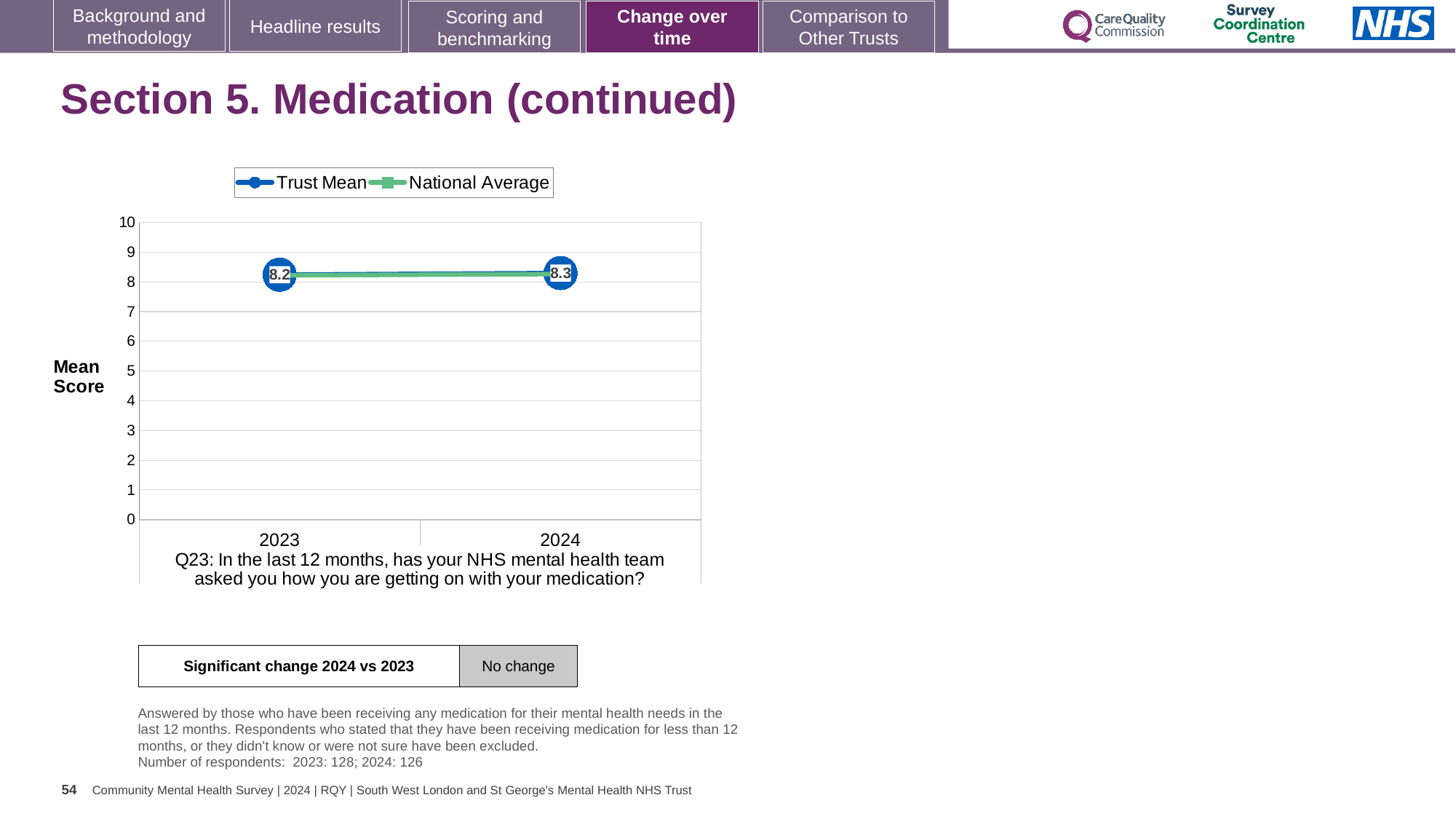
What kind of chart is shown on the slide? line chart What are the two series named in the legend? Trust Mean and National Average Does the Trust Mean rise or fall from 2023 to 2024? rise Which year has the higher Trust Mean, 2023 or 2024? 2024 What is the label on the y axis of the chart? Mean Score How many years are shown on the x axis? 2 Is the National Average value for 2024 greater or less than 7? greater What is the Trust Mean value for 2023? 8.2 Is the Trust Mean value for 2023 greater or less than 5? greater How many series does the legend list? 2 By how much did the Trust Mean change from 2023 to 2024? 0.1 What is the Trust Mean value for 2024? 8.3